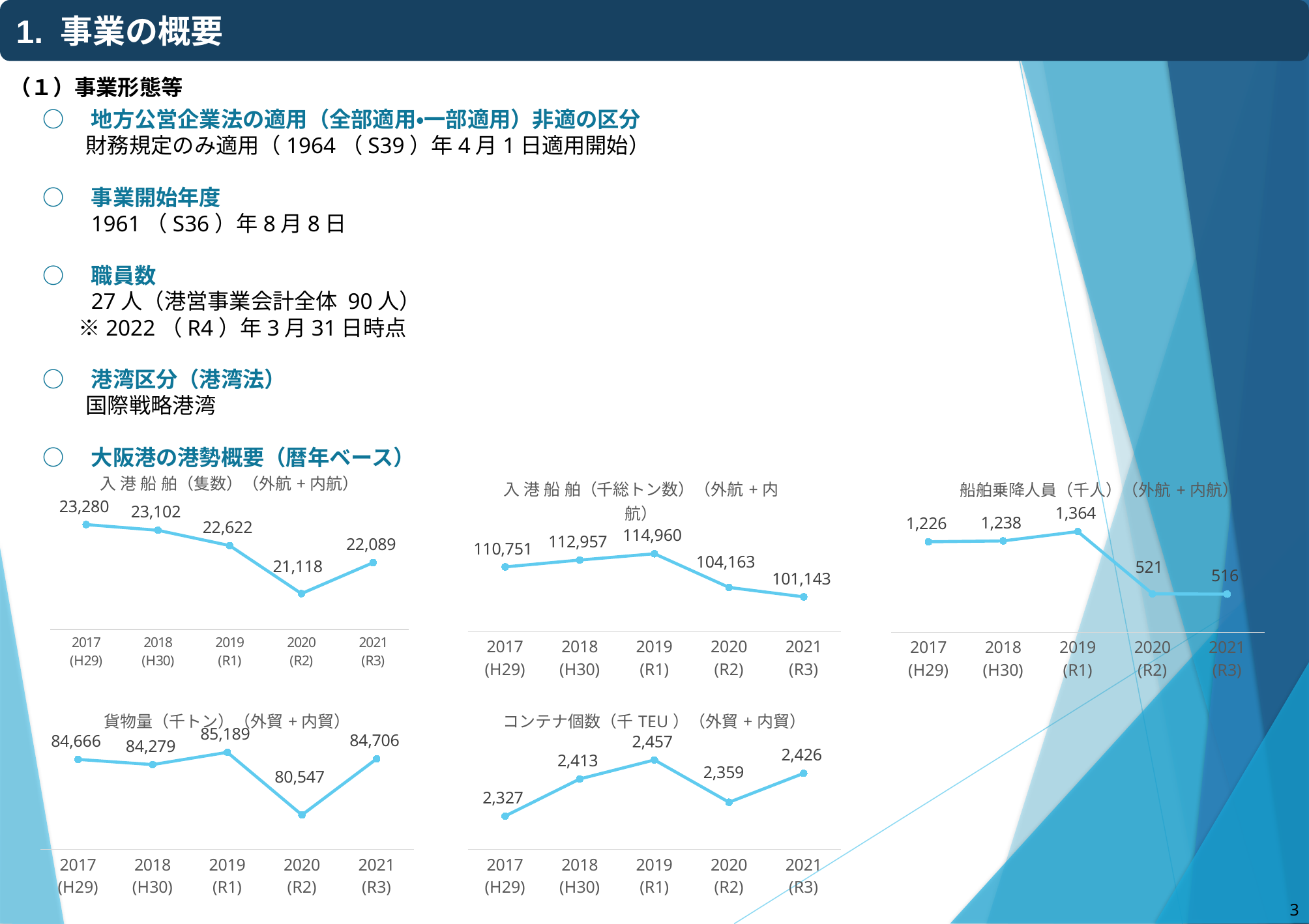
In the 貨物量（千トン） chart, which is larger, the value for 2017 (H29) or 2021 (R3)? 2021 (R3) In the 船舶乗降人員（千人） chart, what is the value for 2021 (R3)? 516 How many data points does the コンテナ個数（千TEU） chart show? 5 In the コンテナ個数（千TEU） chart, which year has the highest value? 2019 (R1) In the 入港船舶（隻数） chart, what is the value for 2020 (R2)? 21,118 In the 入港船舶（千総トン数） chart, what is the value for 2019 (R1)? 114,960 What type of chart is the 貨物量（千トン） chart? Line chart In the 入港船舶（千総トン数） chart, which year has the lowest value? 2021 (R3) In the 貨物量（千トン） chart, what is the value for 2019 (R1)? 85,189 In the 入港船舶（隻数） chart, which year has the highest value? 2017 (H29) In the コンテナ個数（千TEU） chart, what is the value for 2017 (H29)? 2,327 In the 船舶乗降人員（千人） chart, what is the difference between the 2019 (R1) and 2020 (R2) values? 843